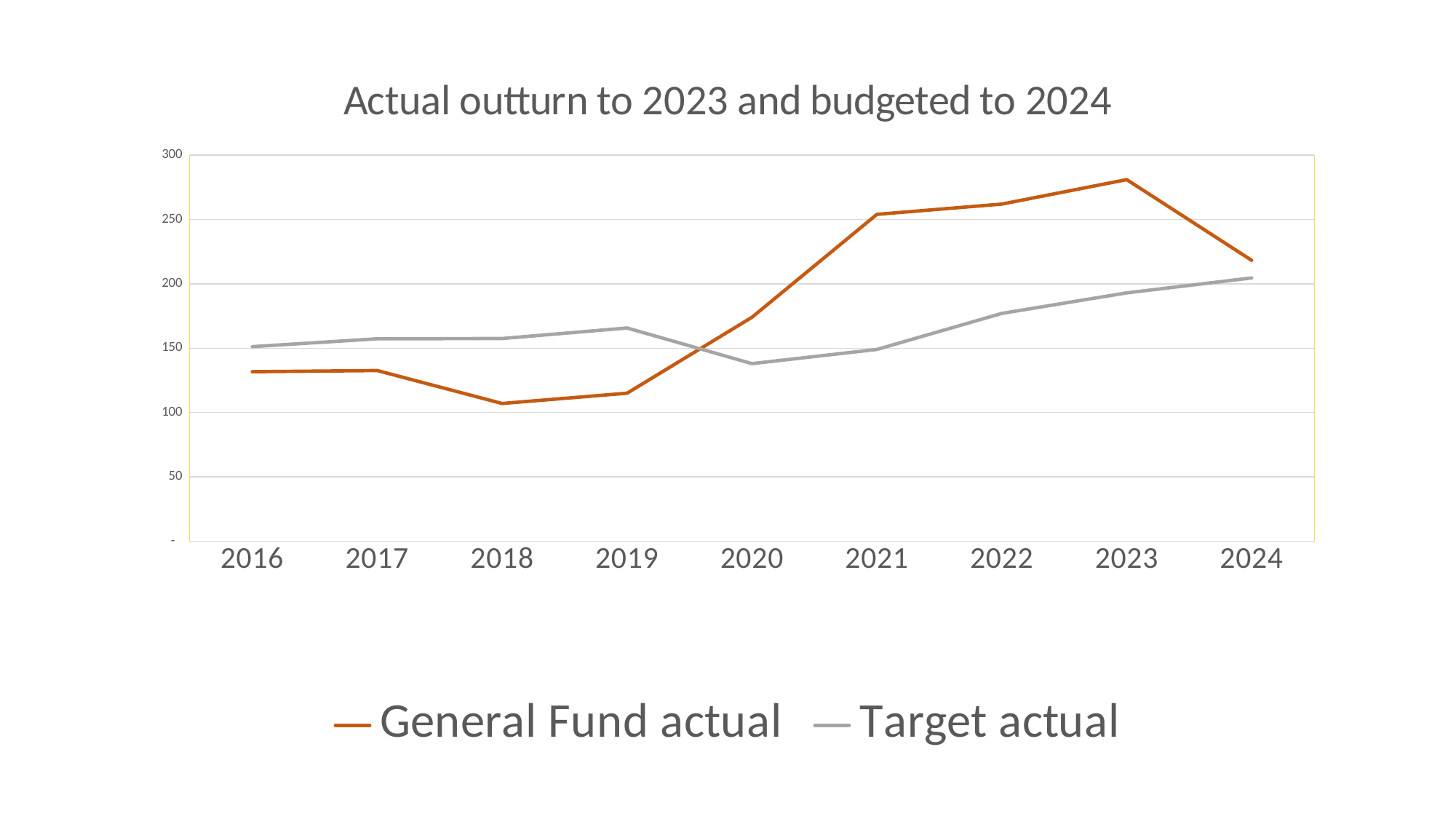
How many series does the legend list? 2 In which year does the General Fund actual line reach its highest value? 2023 In which year does the General Fund actual line reach its lowest value? 2018 In which year does the Target actual line reach its lowest value? 2020 In 2018, which series has the larger value, General Fund actual or Target actual? Target actual What kind of chart is shown on the slide? line chart Is the General Fund actual value for 2023 greater or less than 250? greater What is the title of the chart? Actual outturn to 2023 and budgeted to 2024 In 2021, which series has the larger value, General Fund actual or Target actual? General Fund actual Is the General Fund actual value for 2018 greater or less than 150? less How many years are plotted along the x axis? 9 Is the Target actual value for 2022 greater or less than 150? greater